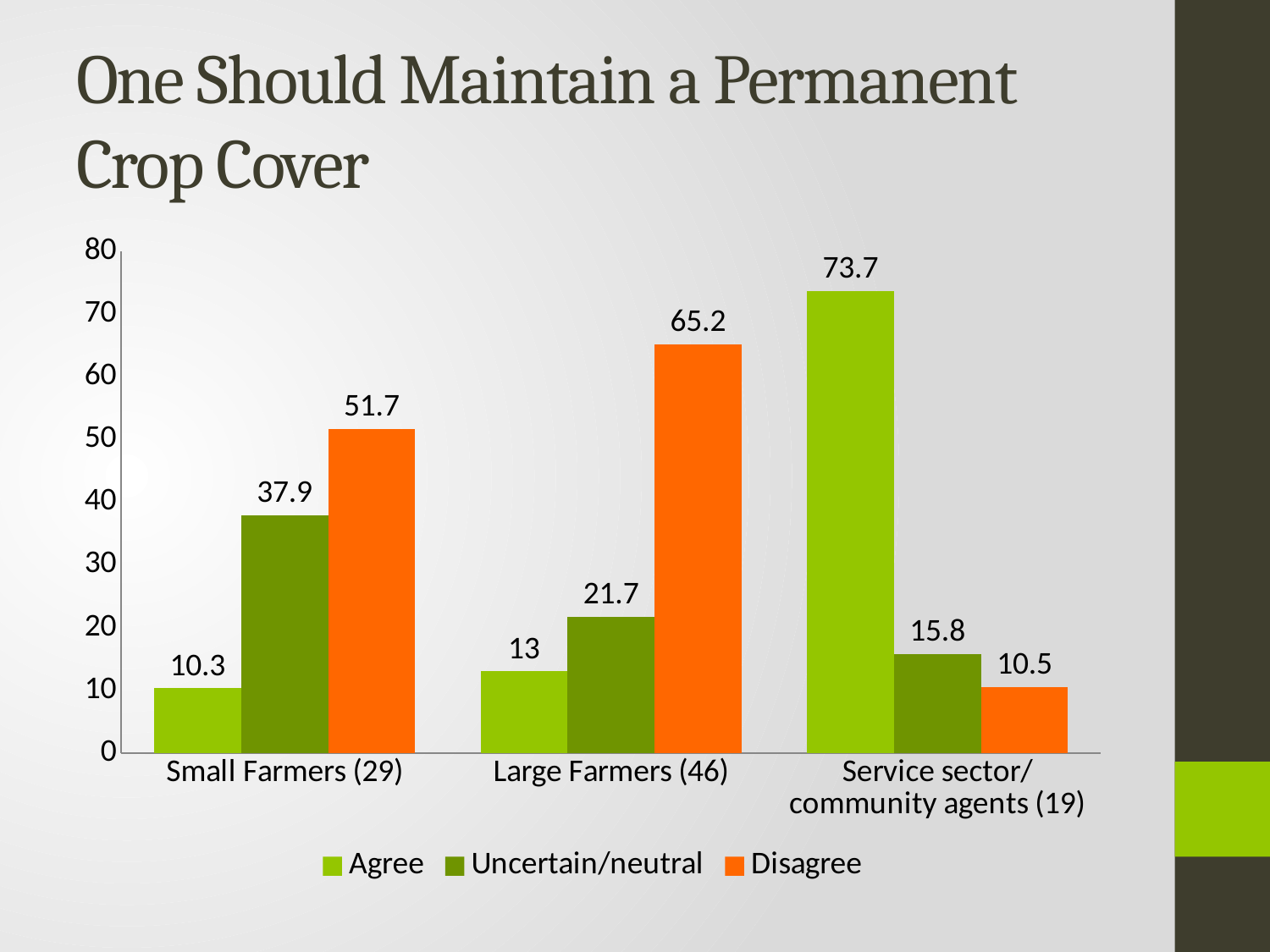
What is the difference between the Disagree values for Large Farmers (46) and Small Farmers (29)? 13.5 What is the Uncertain/neutral value for Service sector/community agents (19)? 15.8 Which category has the lowest Disagree value? Service sector/community agents (19) Which is larger for Small Farmers (29): the Uncertain/neutral value or the Disagree value? Disagree What is the Disagree value for Large Farmers (46)? 65.2 What is the title of the slide? One Should Maintain a Permanent Crop Cover What kind of chart is shown on the slide? bar chart Is the Agree value for Service sector/community agents (19) greater or less than 70? greater How many series does the legend list? 3 Which category has the highest Agree value? Service sector/community agents (19) What is the Agree value for Small Farmers (29)? 10.3 How many categories are shown on the x axis? 3